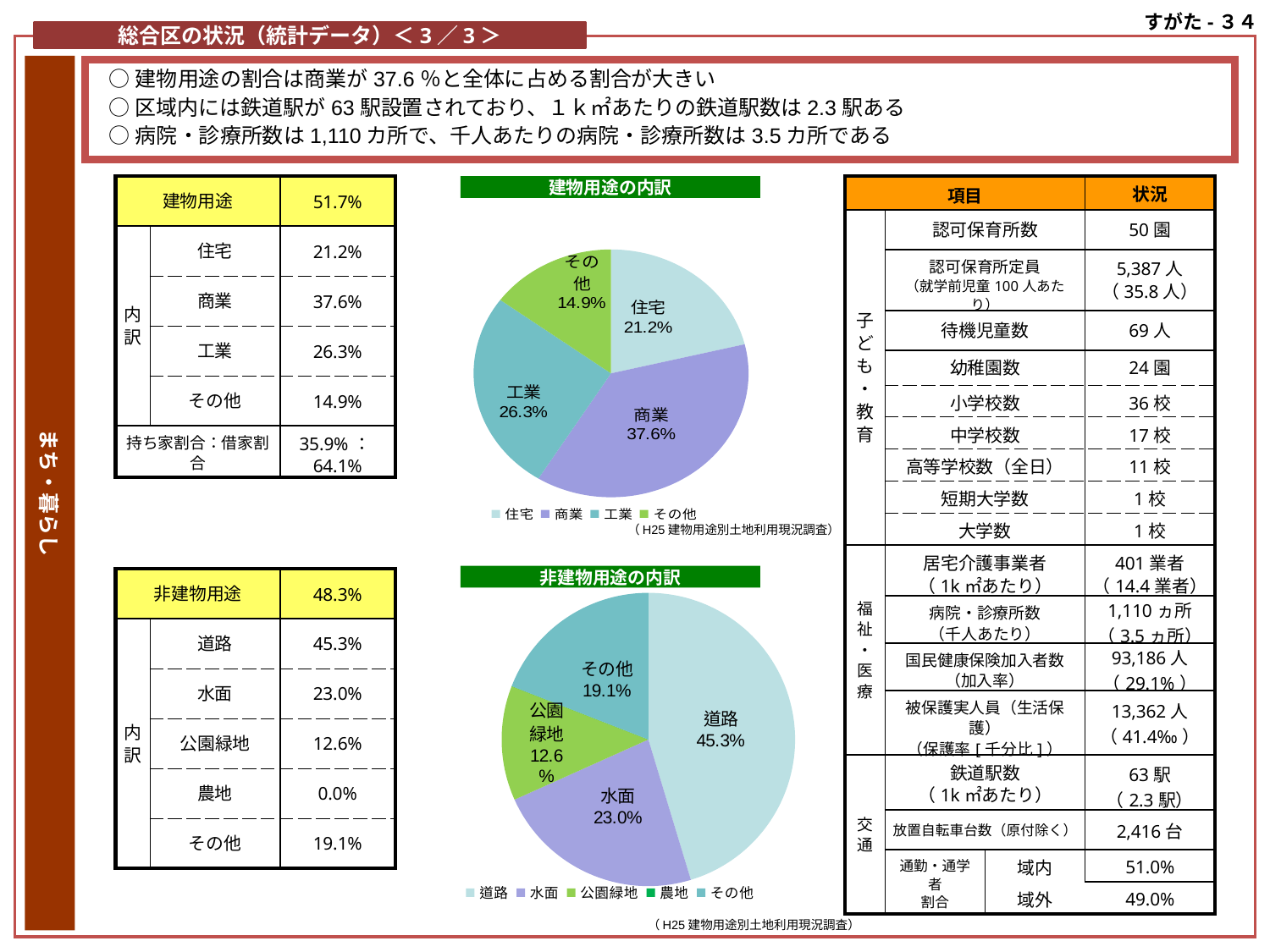
In the 建物用途の内訳 pie chart, how many categories does the legend list? 4 In the 非建物用途の内訳 pie chart, how many categories does the legend list? 5 In the 建物用途の内訳 pie chart, which category has the smallest share? その他 In the 建物用途の内訳 pie chart, what is the difference between the shares of 商業 and 住宅? 16.4% In the 非建物用途の内訳 pie chart, which is larger, その他 or 水面? 水面 In the 建物用途の内訳 pie chart, what is the share for 商業? 37.6% In the 建物用途の内訳 pie chart, which category has the largest share? 商業 In the 非建物用途の内訳 pie chart, which category has the largest share? 道路 In the 非建物用途の内訳 pie chart, what is the share for 水面? 23.0% What type of chart is the 非建物用途の内訳 chart? pie chart In the 建物用途の内訳 pie chart, what is the share for 工業? 26.3% In the 非建物用途の内訳 pie chart, what is the share for 公園緑地? 12.6%